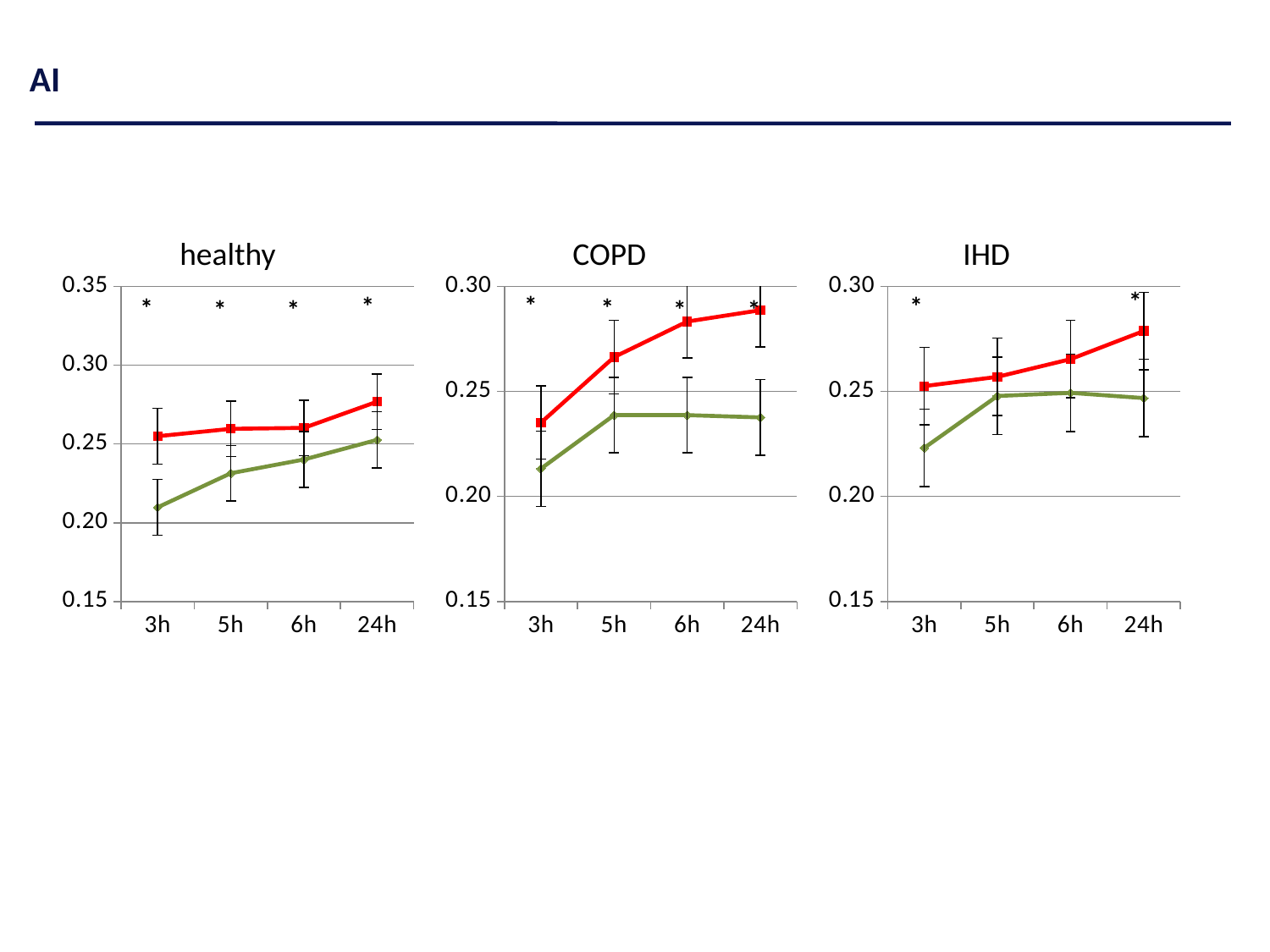
In the 'healthy' chart, is the value of the green line at 5h greater or less than 0.25? less In the 'IHD' chart, is the value of the green line at 3h greater or less than 0.25? less In the 'COPD' chart, does the red line rise or fall from 3h to 24h? rise In the 'healthy' chart, which line is higher at 3h, the red line or the green line? the red line In the 'COPD' chart, is the value of the red line at 3h greater or less than 0.25? less How many time points are shown on the x axis of the 'COPD' chart? 4 In the 'healthy' chart, at which time point is the green line at its lowest value? 3h In the 'COPD' chart, at which time point does the red line reach its highest value? 24h What kind of chart is the 'healthy' chart? line chart